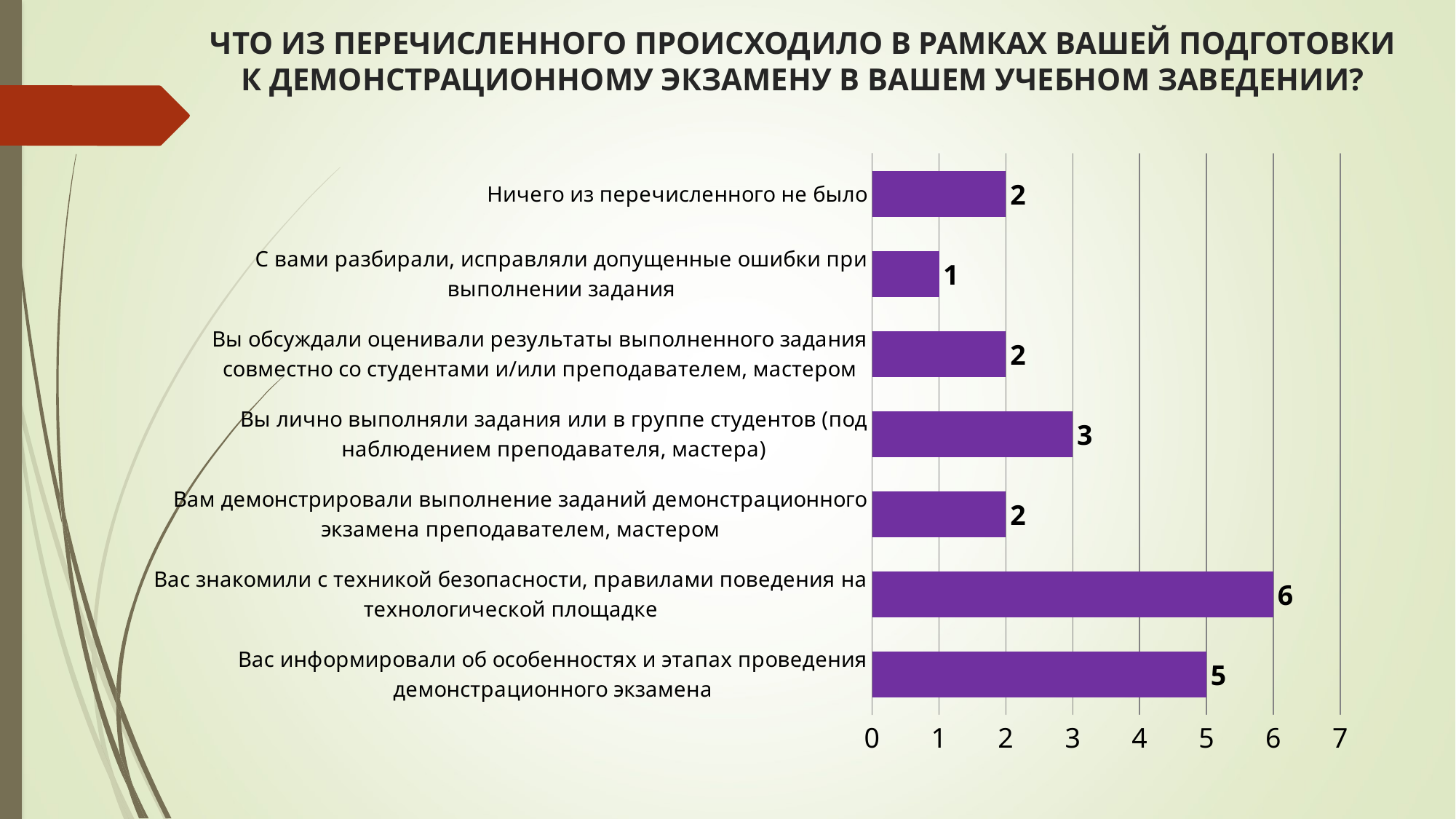
What value is shown for "С вами разбирали, исправляли допущенные ошибки при выполнении задания"? 1 How many categories have a value of 2? 3 Which is larger: the value for "Вы лично выполняли задания или в группе студентов (под наблюдением преподавателя, мастера)" or the value for "Ничего из перечисленного не было"? Вы лично выполняли задания или в группе студентов (под наблюдением преподавателя, мастера) What is the difference between the values for "Вас знакомили с техникой безопасности, правилами поведения на технологической площадке" and "Вас информировали об особенностях и этапах проведения демонстрационного экзамена"? 1 What kind of chart is shown on the slide? Bar chart Which category has the highest value? Вас знакомили с техникой безопасности, правилами поведения на технологической площадке What value is shown for "Вас знакомили с техникой безопасности, правилами поведения на технологической площадке"? 6 What value is shown for "Вы лично выполняли задания или в группе студентов (под наблюдением преподавателя, мастера)"? 3 What value is shown for "Вас информировали об особенностях и этапах проведения демонстрационного экзамена"? 5 Which category has the lowest value? С вами разбирали, исправляли допущенные ошибки при выполнении задания What is the maximum value shown on the horizontal axis? 7 How many categories are shown in the chart? 7